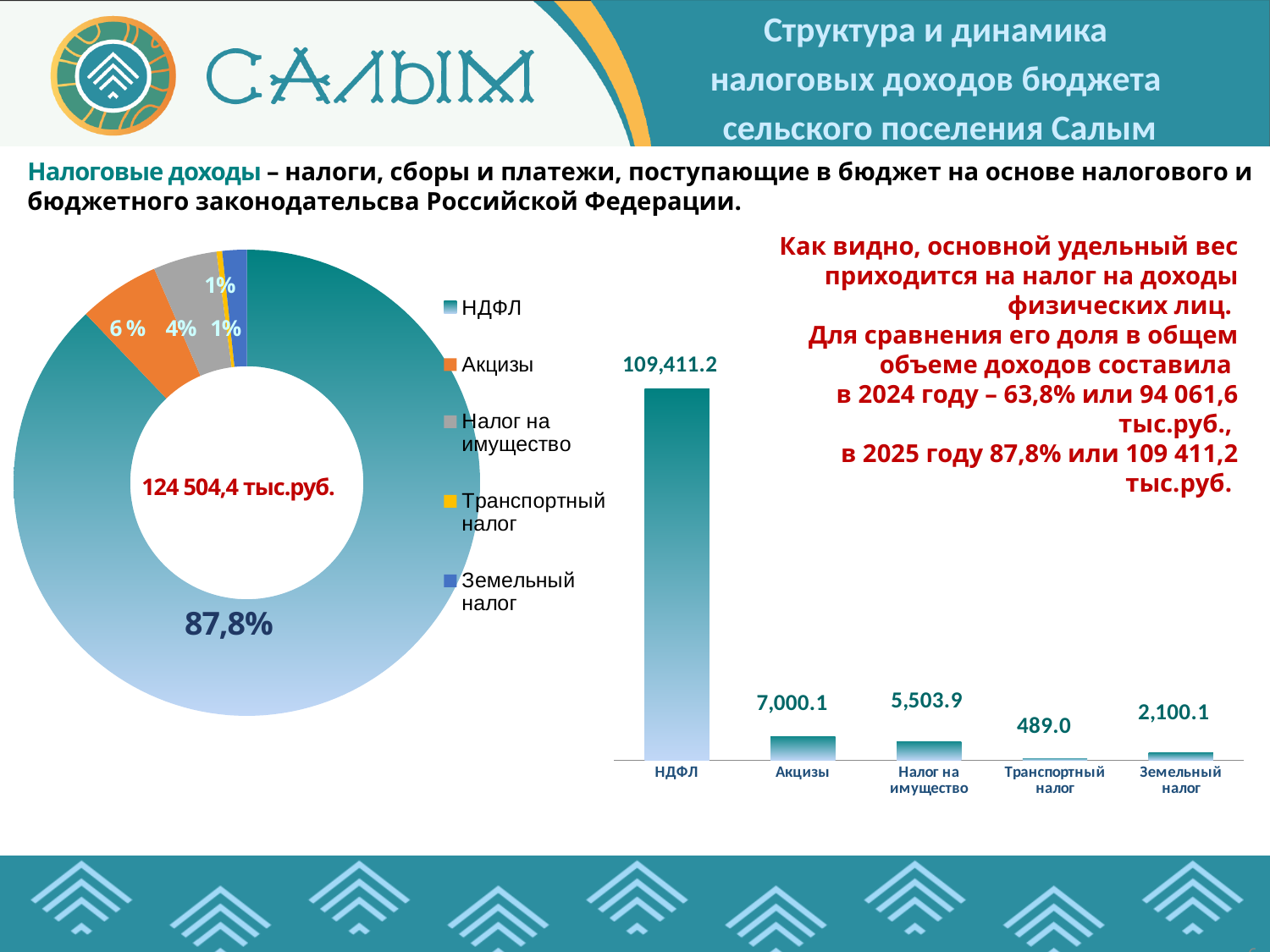
In the bar chart on the right, which category has the highest value? НДФЛ In the bar chart on the right, what is the difference between Акцизы and Налог на имущество? 1,496.2 In the bar chart on the right, what is the value for НДФЛ? 109,411.2 What type of chart is on the right side of the slide? Bar chart How many entries does the legend of the doughnut chart on the left list? 5 In the bar chart on the right, which category has the lowest value? Транспортный налог In the bar chart on the right, which is larger: Земельный налог or Транспортный налог? Земельный налог How many categories are shown in the bar chart on the right? 5 In the bar chart on the right, what is the value for Земельный налог? 2,100.1 In the bar chart on the right, what is the value for Акцизы? 7,000.1 In the doughnut chart on the left, what share does НДФЛ have? 87,8% In the bar chart on the right, what is the value for Транспортный налог? 489.0